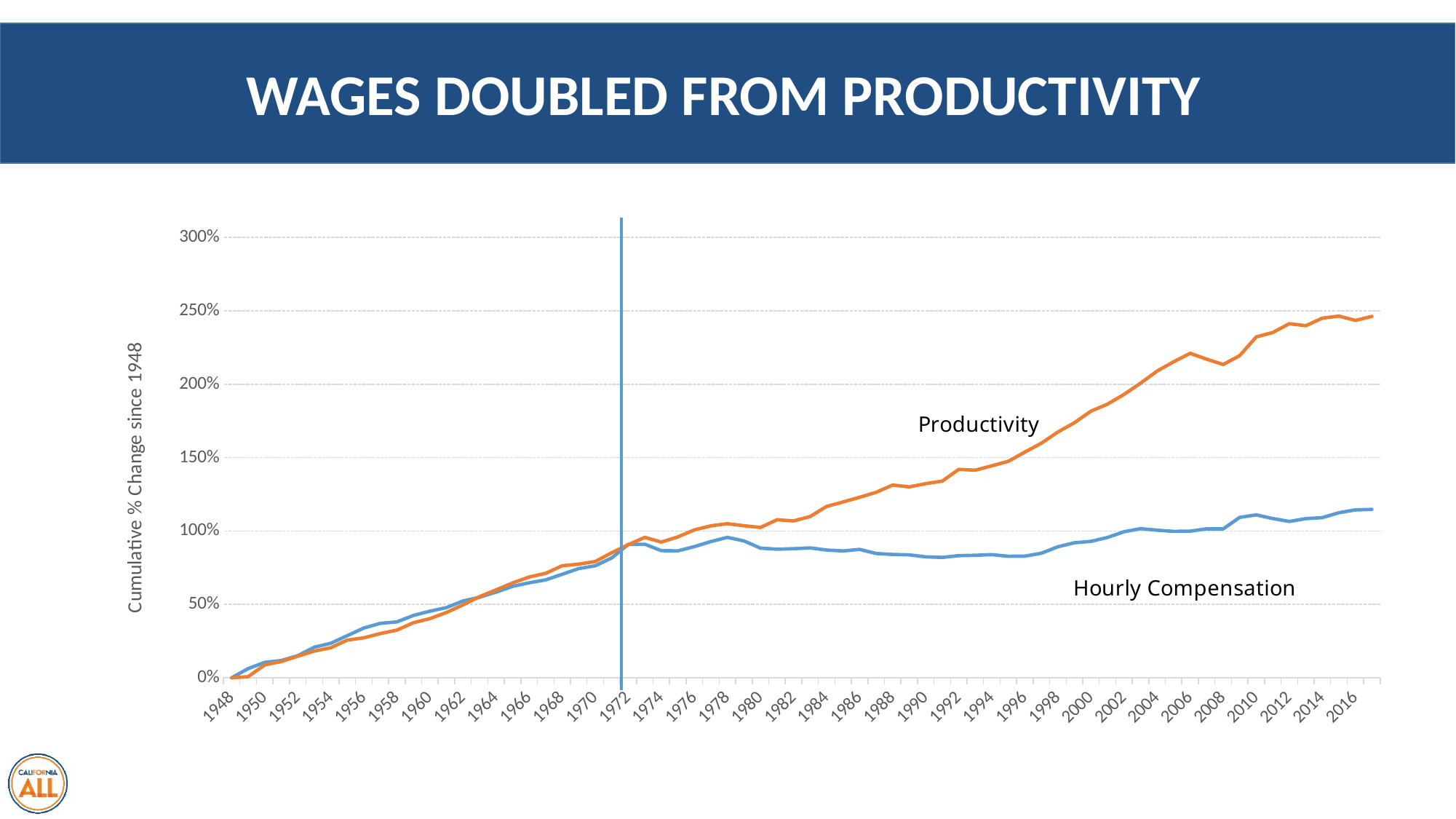
How many data series are plotted on the chart? 2 Does the Productivity series rise or fall overall from 1948 to 2016? Rise Is the value for Productivity in 2006 greater or less than 200%? greater In 2016, which series has the higher value, Productivity or Hourly Compensation? Productivity Is the value for Hourly Compensation in 2016 greater or less than 150%? less Is the value for Productivity in 2016 greater or less than 200%? greater What is the title of the slide? WAGES DOUBLED FROM PRODUCTIVITY What is the first year shown on the x axis of the chart? 1948 What kind of chart is shown on the slide? Line chart What is the label on the vertical axis of the chart? Cumulative % Change since 1948